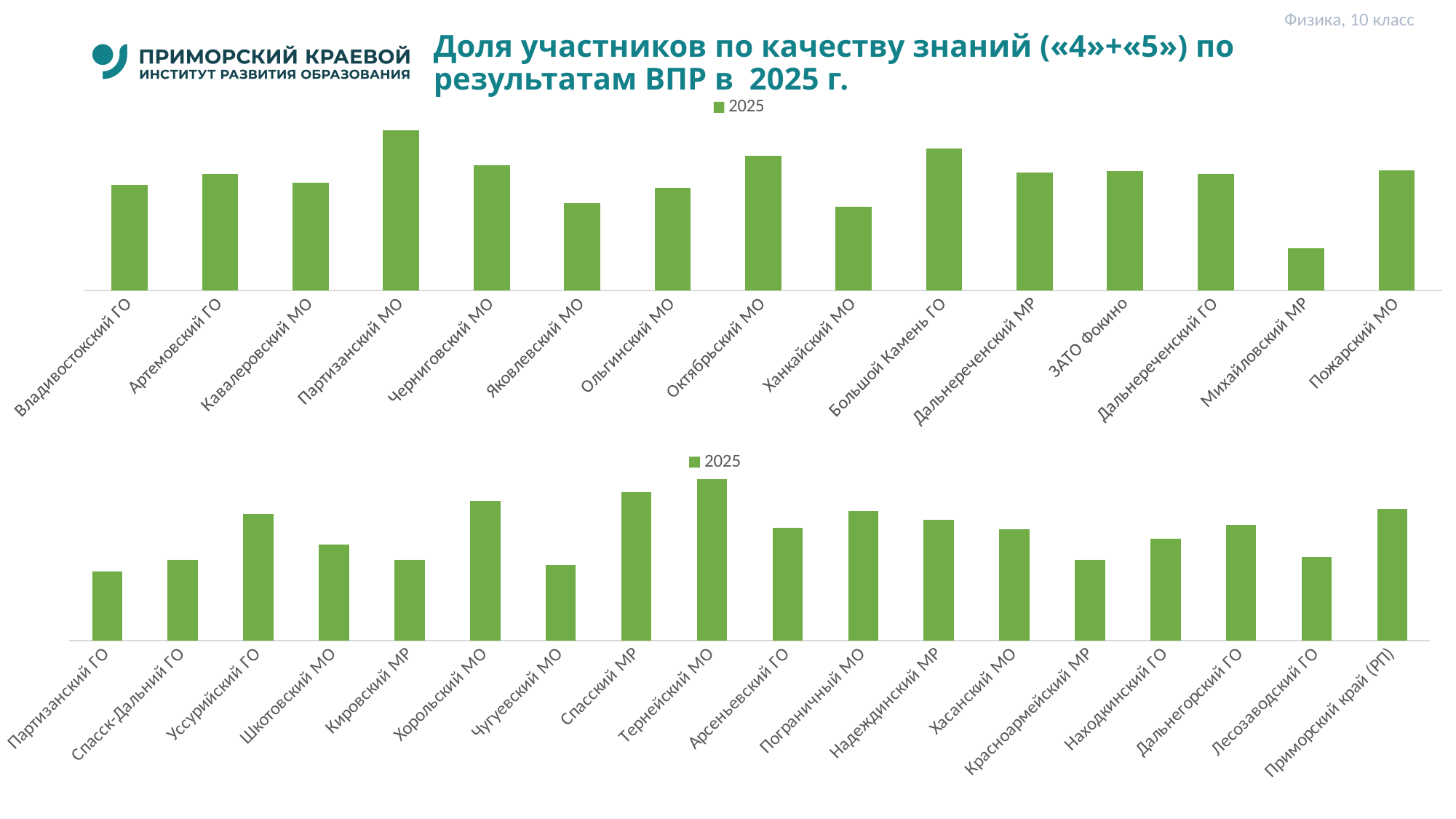
On the top chart, which category has the lowest value? Михайловский МР What kind of chart is the top chart on the slide? bar chart What colour are the bars on the top chart? green What entry does the legend of the bottom chart show? 2025 On the bottom chart, which is larger: the value for Спасский МР or the value for Шкотовский МО? Спасский МР On the bottom chart, which is larger: the value for Хорольский МО or the value for Чугуевский МО? Хорольский МО How many categories are shown on the bottom chart? 18 How many categories are shown on the top chart? 15 On the top chart, which is larger: the value for Партизанский МО or the value for Яковлевский МО? Партизанский МО On the top chart, which category has the highest value? Партизанский МО How many series does the legend of the top chart list? 1 On the bottom chart, which category has the highest value? Тернейский МО